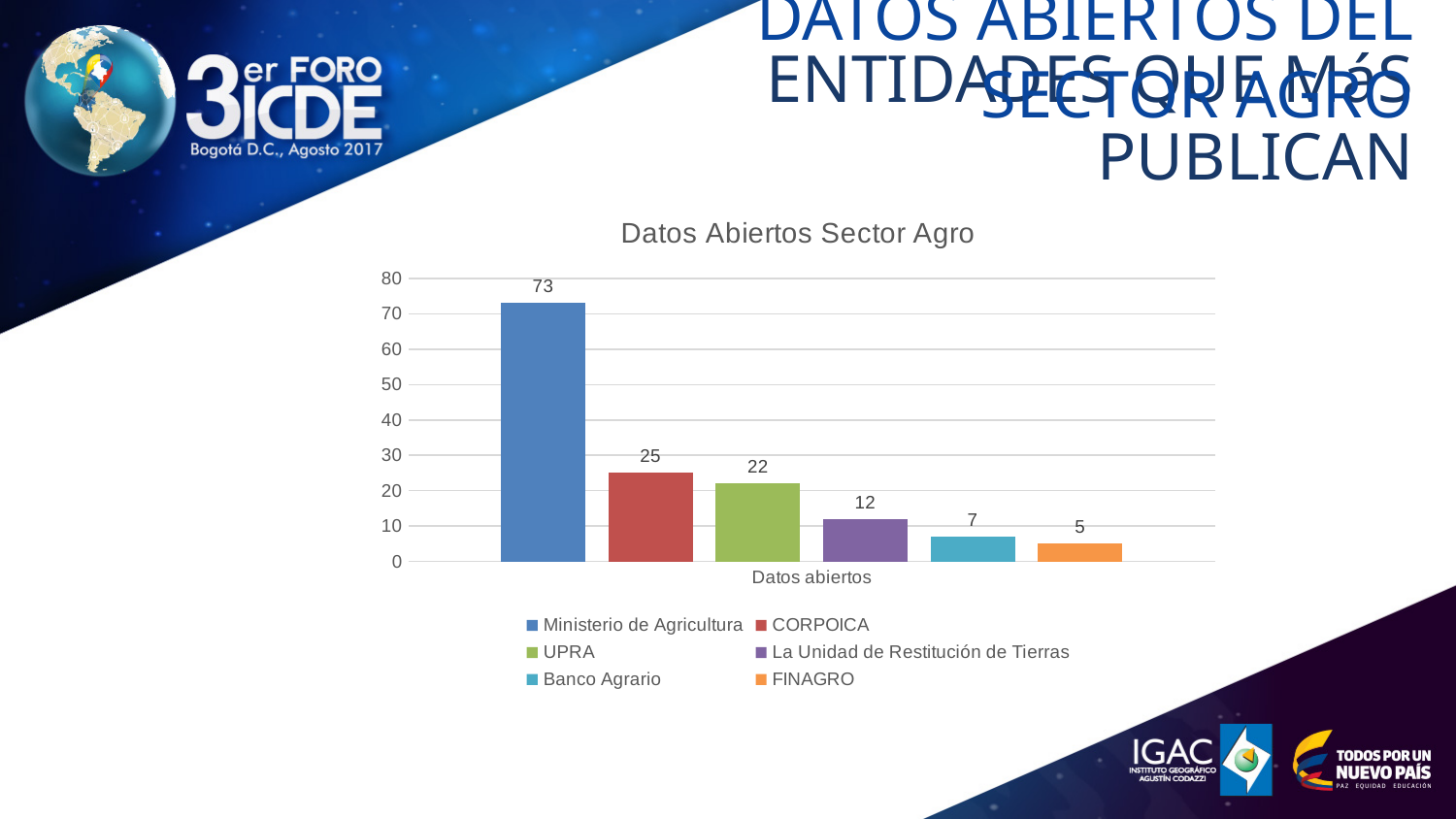
What is the difference between the values for UPRA and Banco Agrario? 15 What is the difference between the values for Ministerio de Agricultura and CORPOICA? 48 What is the value for CORPOICA in the chart? 25 Which series has the highest value in the chart? Ministerio de Agricultura Which is larger, the value for CORPOICA or the value for UPRA? CORPOICA What is the value for FINAGRO in the chart? 5 What is the value for La Unidad de Restitución de Tierras in the chart? 12 How many series does the legend list? 6 Which series has the lowest value in the chart? FINAGRO What is the title of the chart? Datos Abiertos Sector Agro What is the value for Ministerio de Agricultura in the chart? 73 What kind of chart is shown on the slide? Bar chart